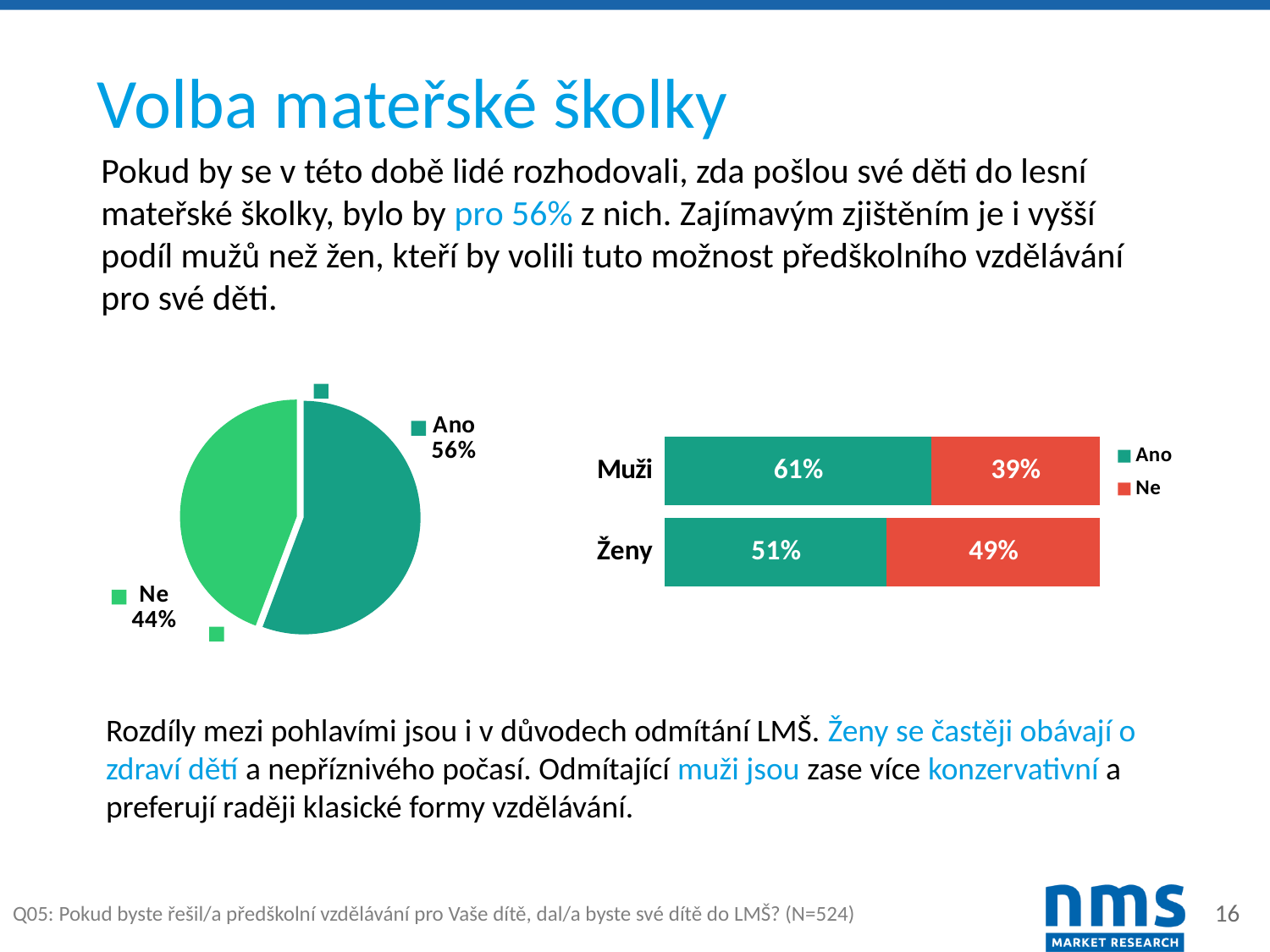
In the bar chart on the right, what is the "Ano" value for Muži? 61% In the bar chart on the right, what is the "Ne" value for Ženy? 49% In the pie chart on the left, what share of respondents answered "Ano"? 56% How many series does the legend of the bar chart on the right list? 2 In the pie chart on the left, how many slices are there? 2 In the pie chart on the left, what share of respondents answered "Ne"? 44% In the bar chart on the right, which group has the higher "Ano" value, Muži or Ženy? Muži In the pie chart on the left, which answer has the larger share, "Ano" or "Ne"? Ano In the bar chart on the right, what is the total of the Muži bar (Ano plus Ne)? 100% What kind of chart is the chart on the right? bar chart What kind of chart is the chart on the left? pie chart In the bar chart on the right, what is the difference between the "Ano" values for Muži and Ženy? 10%